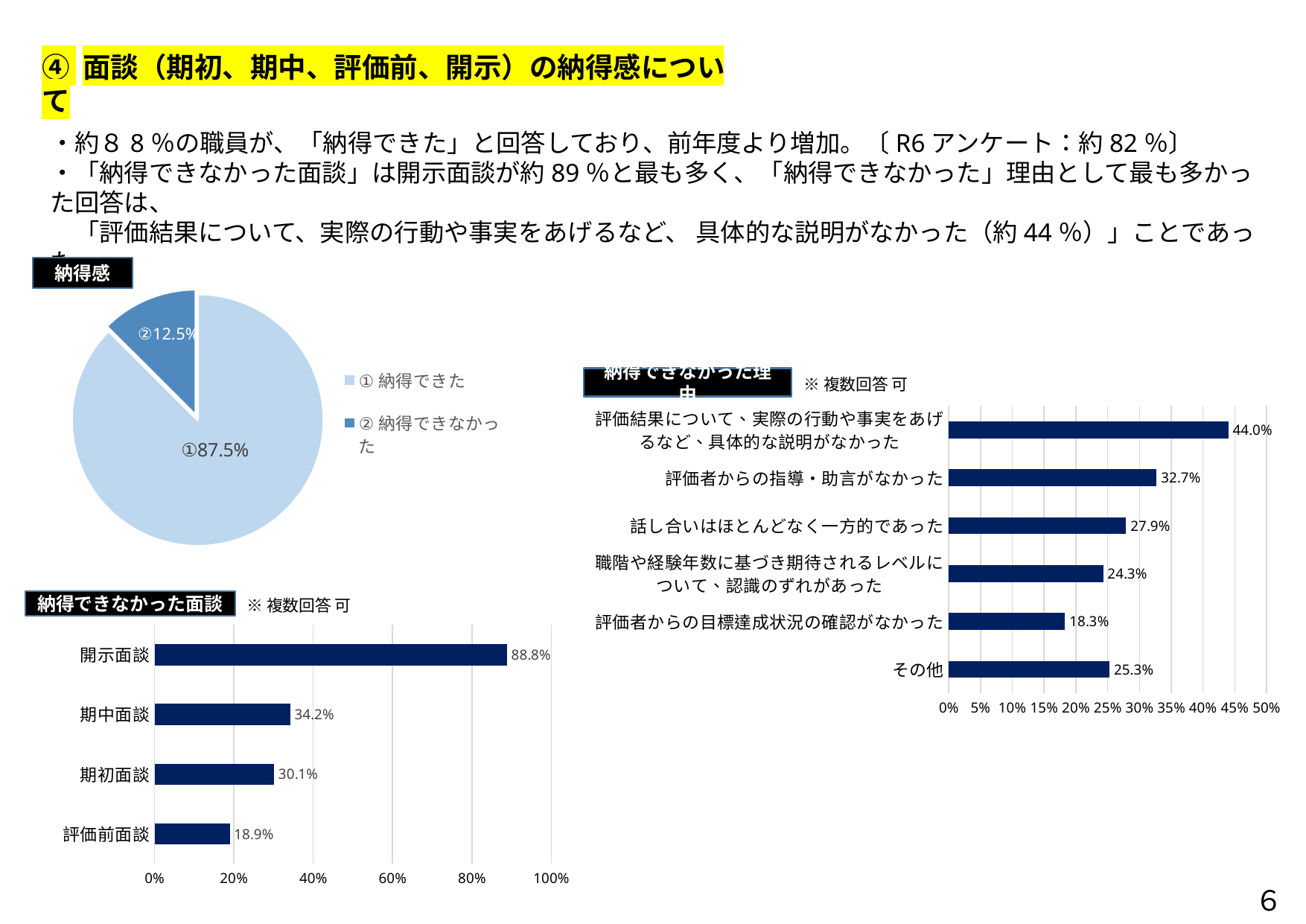
In the 納得感 pie chart, what share of respondents answered ② 納得できなかった? 12.5% In the 納得できなかった面談 chart, which category has the lowest value? 評価前面談 In the 納得できなかった理由 chart, which category has the highest value? 評価結果について、実際の行動や事実をあげるなど、具体的な説明がなかった In the 納得できなかった理由 chart, which is larger: その他 or 職階や経験年数に基づき期待されるレベルについて、認識のずれがあった? その他 In the 納得できなかった理由 chart, what is the value for 評価者からの指導・助言がなかった? 32.7% What kind of chart is the 納得感 chart? Pie chart In the 納得できなかった面談 chart, what is the difference between 期中面談 and 期初面談? 4.1% In the 納得できなかった面談 chart, what is the value for 開示面談? 88.8% How many categories are shown in the 納得できなかった面談 chart? 4 How many categories are shown in the 納得できなかった理由 chart? 6 In the 納得感 pie chart, what share of respondents answered ① 納得できた? 87.5% What kind of chart is the 納得できなかった面談 chart? Bar chart